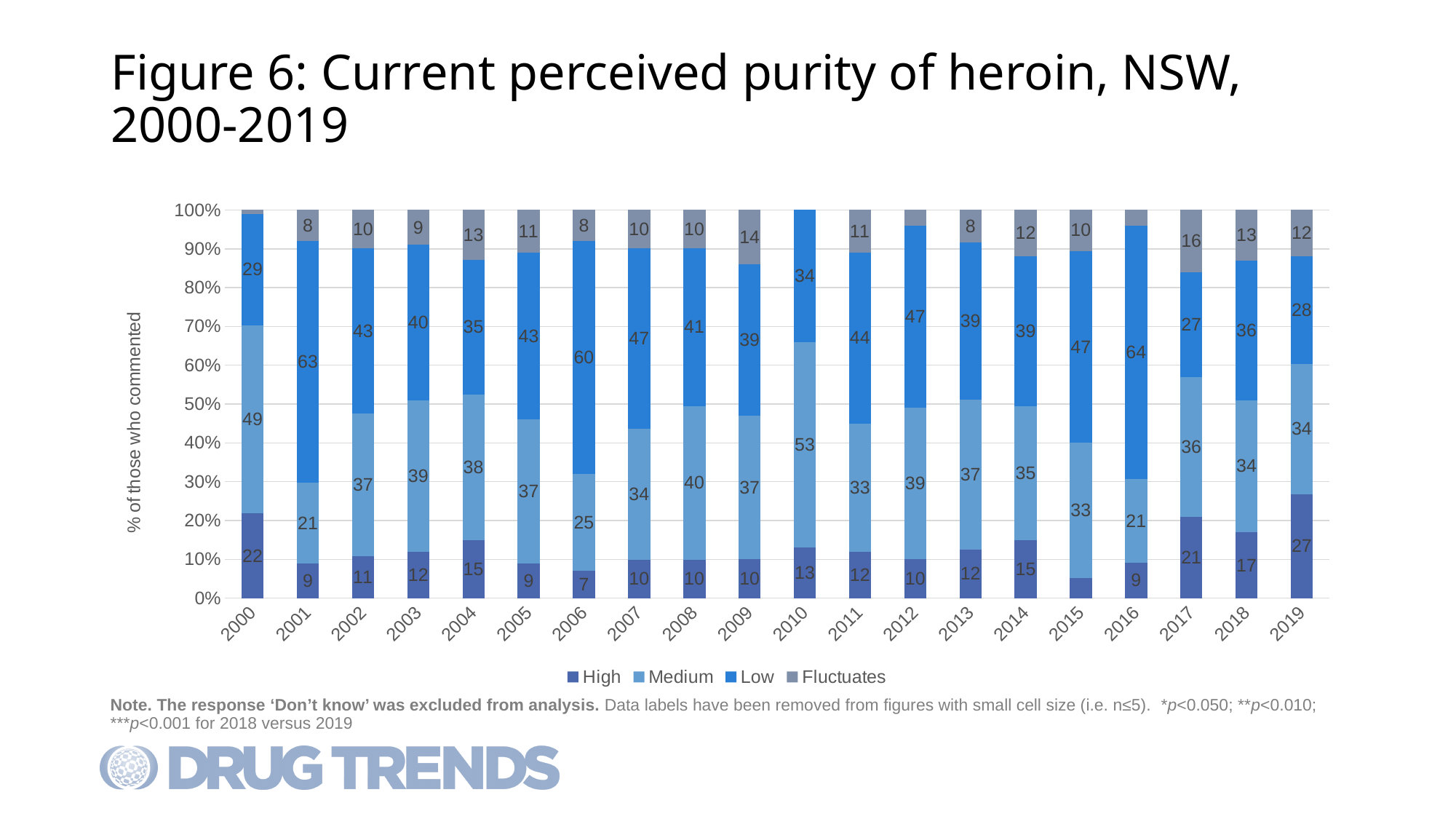
What is the value for Fluctuates in 2017? 16 What kind of chart is shown on the slide? Stacked bar chart What is the label on the y axis? % of those who commented How many years are shown on the x axis? 20 What is the value for Low in 2016? 64 In which year is the High series at its highest? 2019 In which year is the Low series at its lowest? 2017 What is the value for High in 2000? 22 How many series does the legend list? 4 Which is larger, the Medium value in 2008 or the Medium value in 2009? 2008 What is the difference between the Low values for 2001 and 2002? 20 What is the value for Medium in 2010? 53